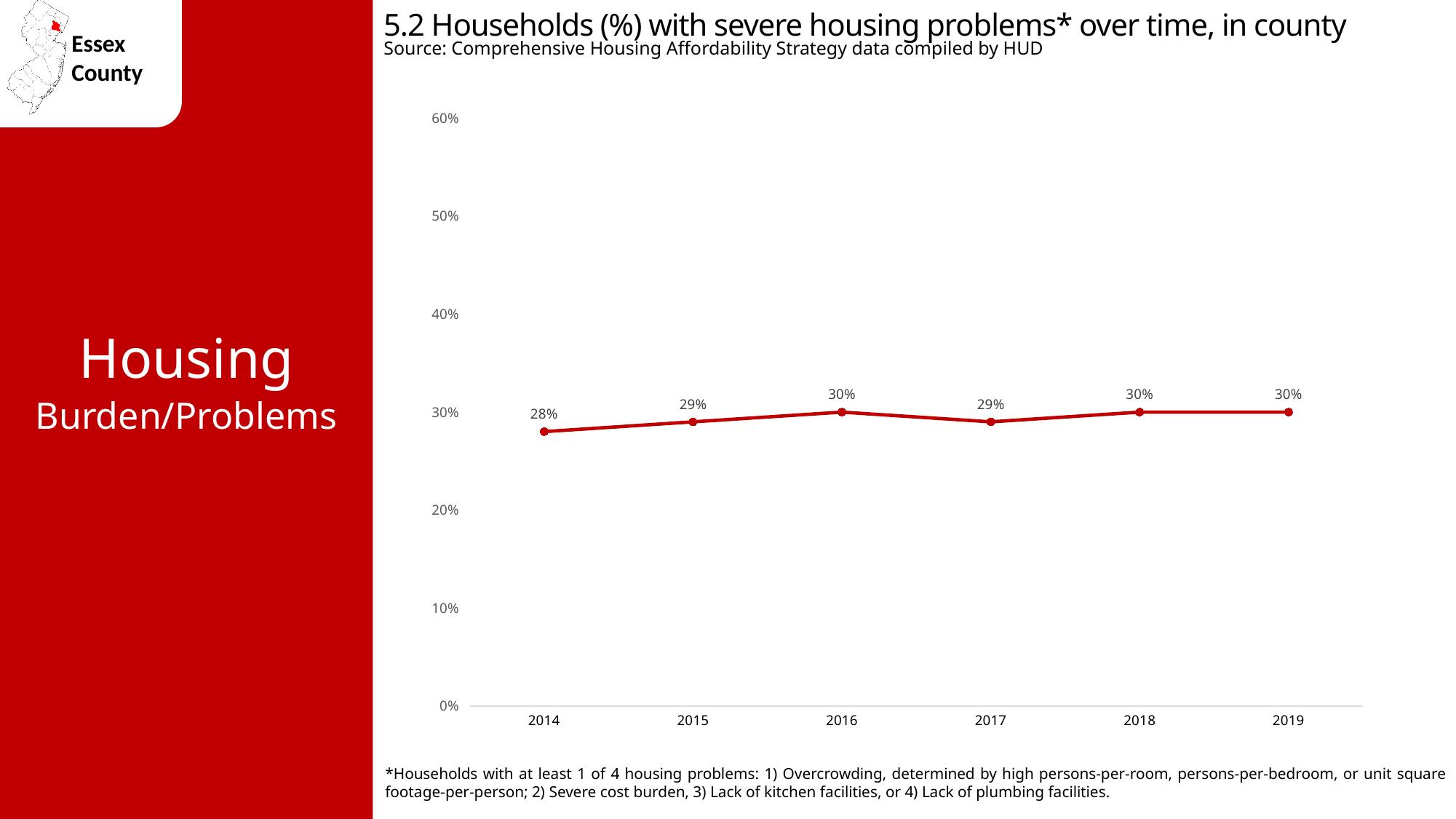
Which year has the lowest percentage of households with severe housing problems? 2014 What kind of chart is shown on the slide? line chart What is the title of the chart? 5.2 Households (%) with severe housing problems* over time, in county What is the value shown for 2019? 30% What percentage of households had severe housing problems in 2014? 28% How many years are plotted on the chart? 6 What is the value shown for 2017? 29% Overall, do the values rise or fall from 2014 to 2019? rise Is the value for 2016 greater or less than 40%? less What is the source of the data shown in the chart? Comprehensive Housing Affordability Strategy data compiled by HUD Which is larger, the value for 2015 or the value for 2018? 2018 What is the difference between the 2016 value and the 2014 value? 2%